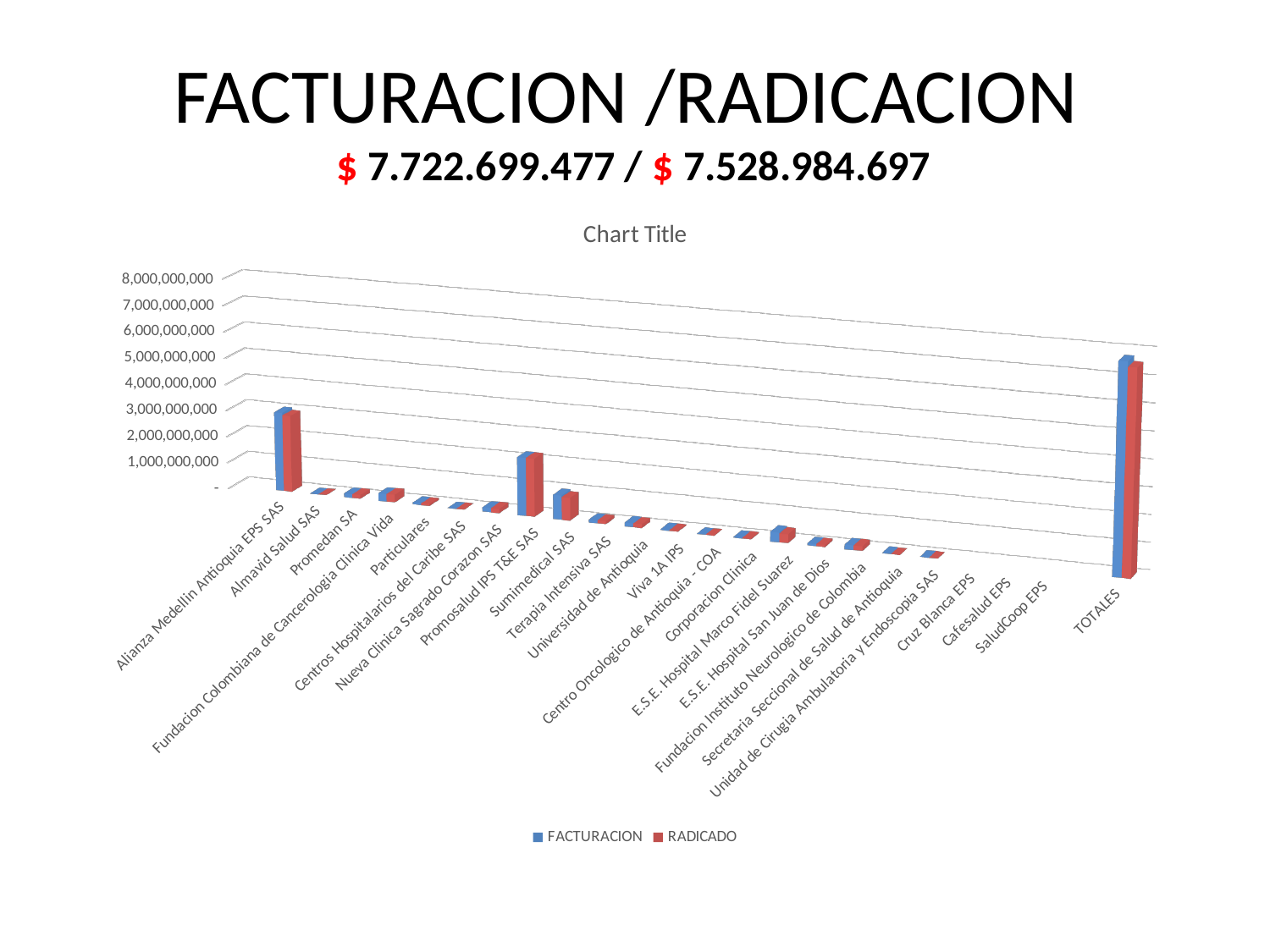
Which colour represents the RADICADO series in the chart? Red Which has the larger FACTURACION bar, Promosalud IPS T&E SAS or Sumimedical SAS? Promosalud IPS T&E SAS Which category has the highest bars in the chart? TOTALES How many categories are shown along the x axis of the chart? 23 Is the FACTURACION value for Promosalud IPS T&E SAS greater or less than 3,000,000,000? less How many series does the chart legend list? 2 Which has the larger FACTURACION bar, Alianza Medellin Antioquia EPS SAS or Promosalud IPS T&E SAS? Alianza Medellin Antioquia EPS SAS What are the two series named in the chart legend? FACTURACION and RADICADO What kind of chart is shown on the slide? Bar chart Is the FACTURACION value for TOTALES greater or less than 4,000,000,000? greater Excluding TOTALES, which category has the highest FACTURACION bar? Alianza Medellin Antioquia EPS SAS Is the FACTURACION value for Alianza Medellin Antioquia EPS SAS greater or less than 1,000,000,000? greater